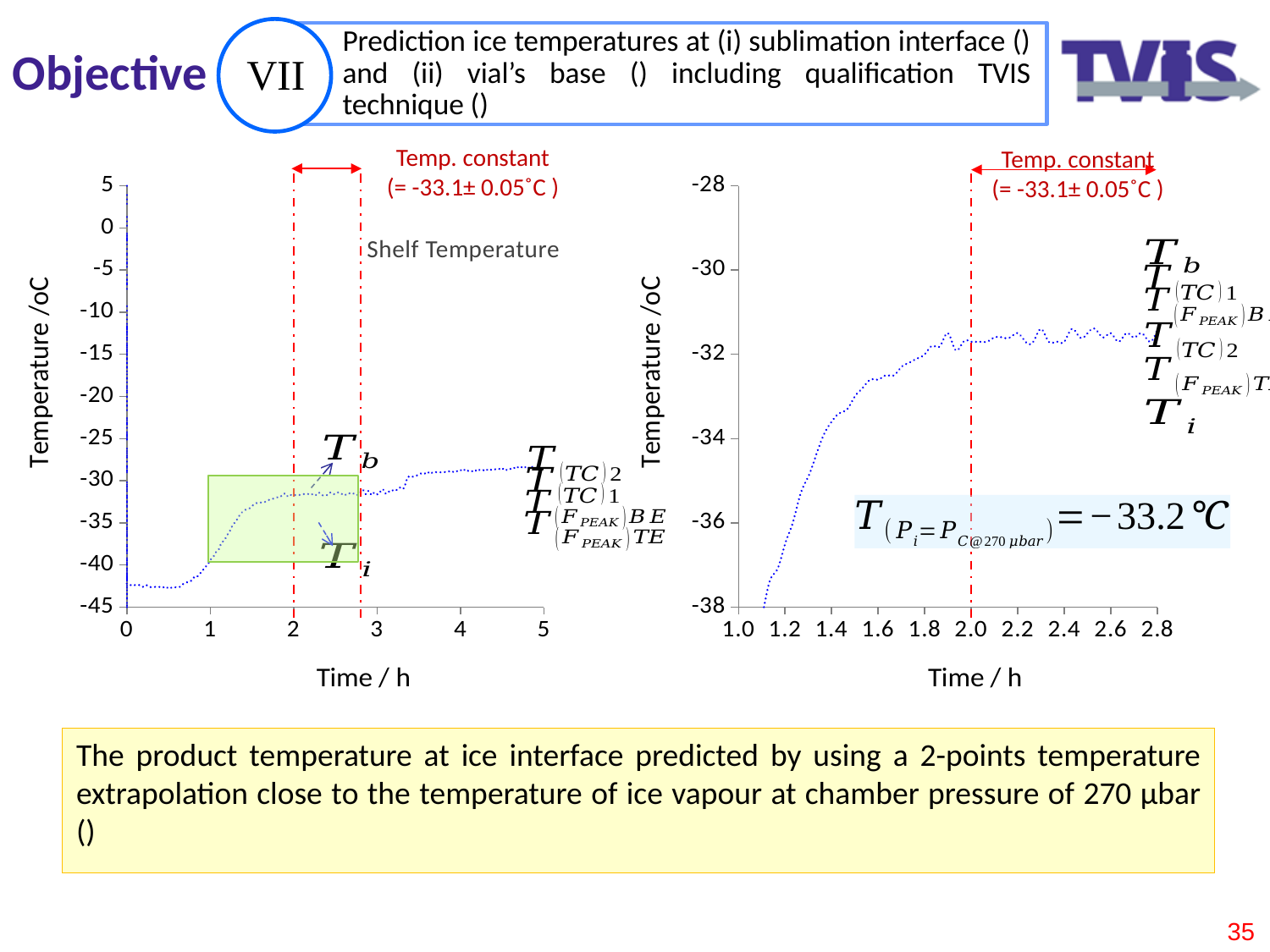
On the left chart, what is the label of the y axis? Temperature /oC On the right chart, what is the label of the x axis? Time / h On the right chart, what predicted ice interface temperature is printed in the annotation for chamber pressure 270 µbar? -33.2 °C On the left chart, is the temperature at time 5 h greater or less than -35? greater What kind of chart is the right chart (Time / h from 1.0 to 2.8)? line chart On the right chart, does the temperature rise or fall as time increases from 1.0 to 2.8 h? rise On the right chart, is the temperature at time 2.4 h greater or less than -34? greater What constant temperature value is printed in the 'Temp. constant' annotation on the charts? -33.1± 0.05˚C On the right chart, is the temperature at time 1.2 h greater or less than -34? less On the left chart, does the temperature rise or fall as time increases from 0 to 5 h? rise What kind of chart is the left chart (Time / h from 0 to 5)? line chart